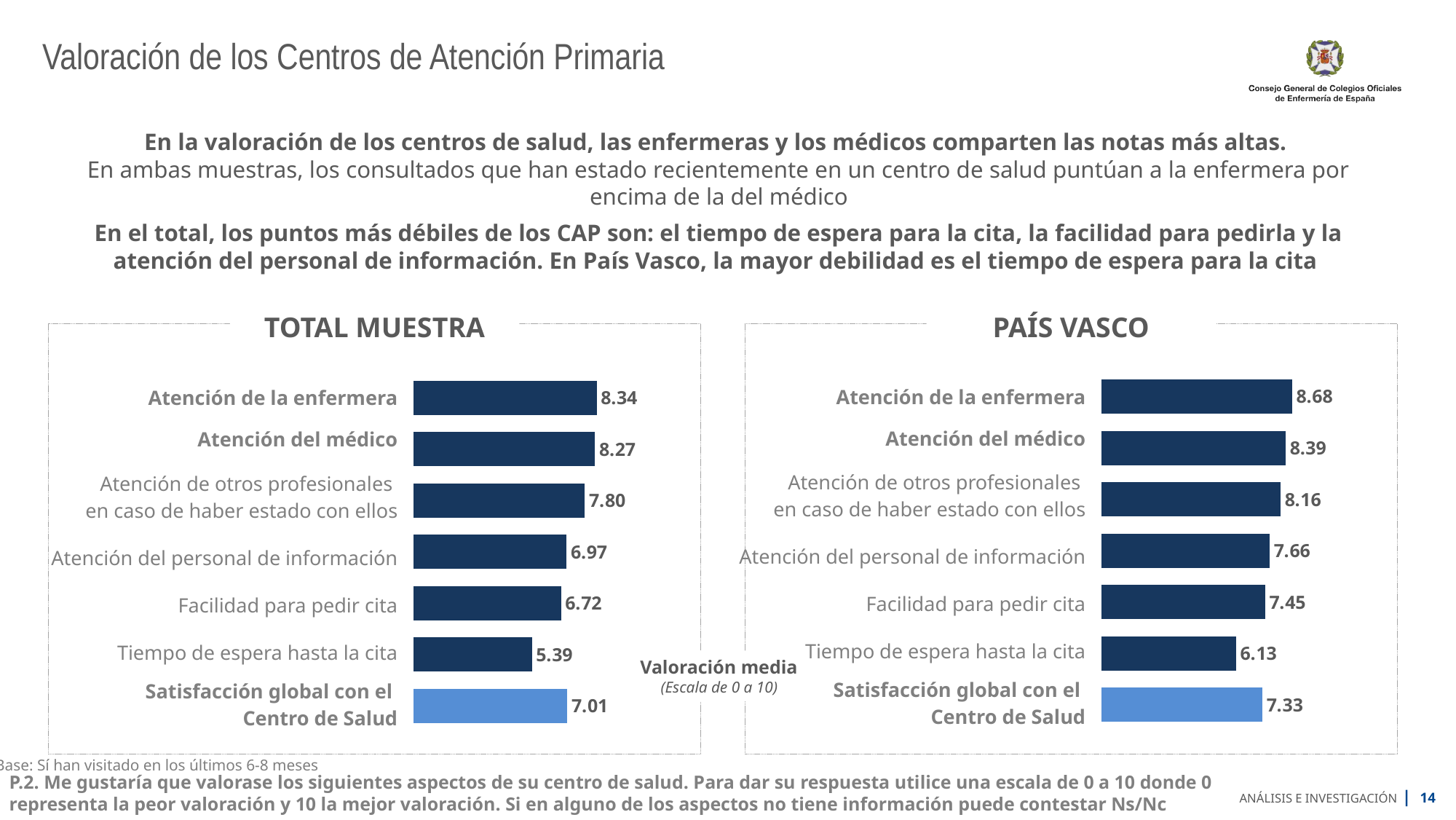
In the PAÍS VASCO chart, which category has the highest value? Atención de la enfermera In the TOTAL MUESTRA chart, what is the value for Atención de la enfermera? 8.34 In the PAÍS VASCO chart, what is the value for Tiempo de espera hasta la cita? 6.13 In the TOTAL MUESTRA chart, which bar is shown in a lighter blue colour than the others? Satisfacción global con el Centro de Salud In the TOTAL MUESTRA chart, what is the difference between Atención de la enfermera and Atención del médico? 0.07 Which is larger: Facilidad para pedir cita in the TOTAL MUESTRA chart or Facilidad para pedir cita in the PAÍS VASCO chart? PAÍS VASCO In the PAÍS VASCO chart, what is the difference between Atención del personal de información and Facilidad para pedir cita? 0.21 In the TOTAL MUESTRA chart, which category has the lowest value? Tiempo de espera hasta la cita What type of chart is the PAÍS VASCO chart? Bar chart In the PAÍS VASCO chart, what is the value for Satisfacción global con el Centro de Salud? 7.33 What scale is used for the values shown in both charts, according to the note between them? Escala de 0 a 10 How many categories are shown in the TOTAL MUESTRA chart? 7